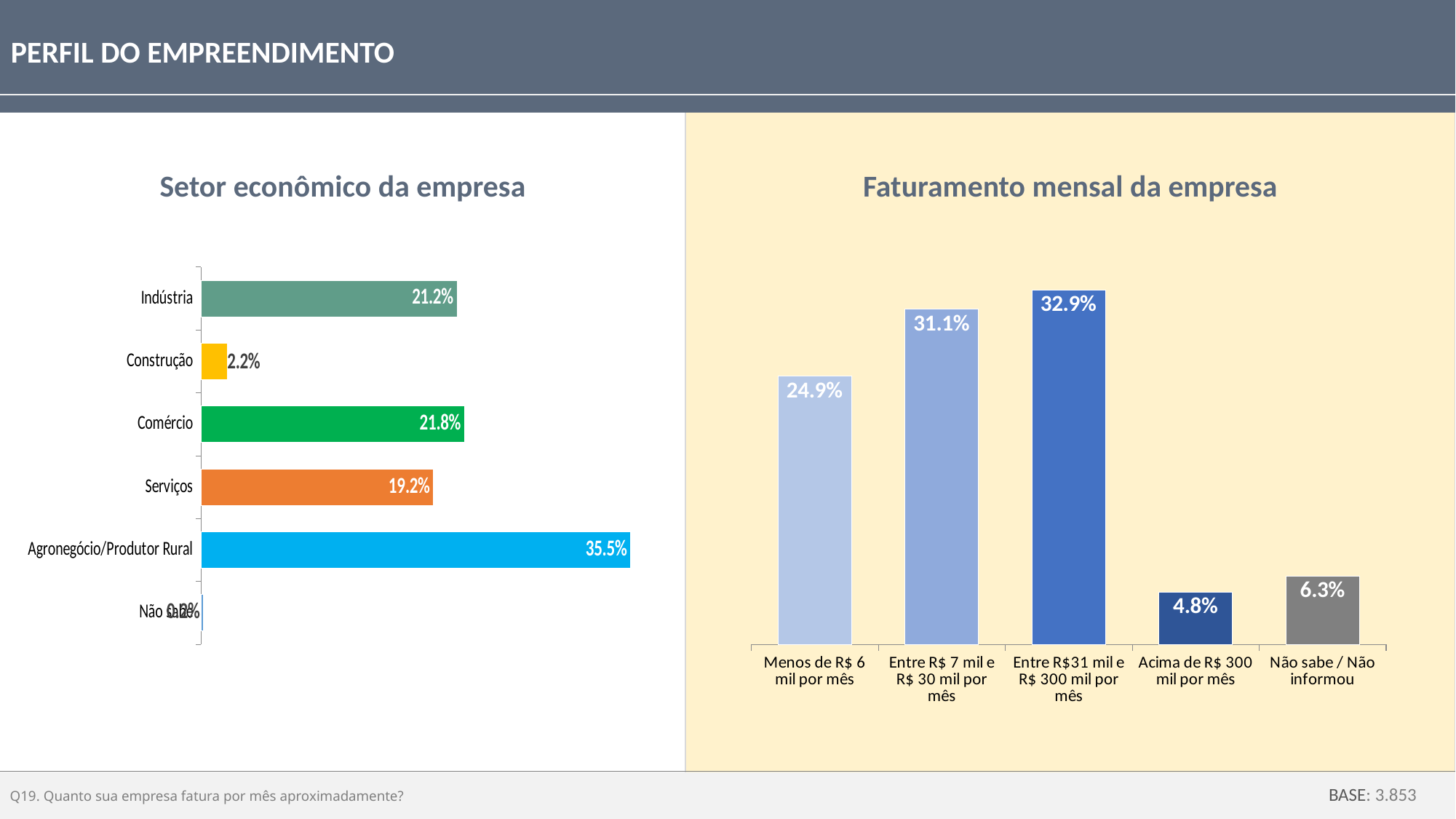
In the 'Faturamento mensal da empresa' chart, what is the value for 'Acima de R$ 300 mil por mês'? 4.8% What kind of chart is 'Setor econômico da empresa'? Bar chart What is the title of the chart on the right side of the slide? Faturamento mensal da empresa How many categories are shown in the 'Faturamento mensal da empresa' chart? 5 In the 'Faturamento mensal da empresa' chart, what is the difference between 'Entre R$ 7 mil e R$ 30 mil por mês' and 'Menos de R$ 6 mil por mês'? 6.2% In the 'Faturamento mensal da empresa' chart, what is the value for 'Entre R$31 mil e R$ 300 mil por mês'? 32.9% In the 'Setor econômico da empresa' chart, which sector has the highest value? Agronegócio/Produtor Rural In the 'Setor econômico da empresa' chart, which is larger, Indústria or Serviços? Indústria In the 'Setor econômico da empresa' chart, what is the value for Construção? 2.2% In the 'Setor econômico da empresa' chart, what is the value for Agronegócio/Produtor Rural? 35.5% In the 'Faturamento mensal da empresa' chart, which category has the lowest value? Acima de R$ 300 mil por mês In the 'Setor econômico da empresa' chart, what is the difference between Comércio and Serviços? 2.6%